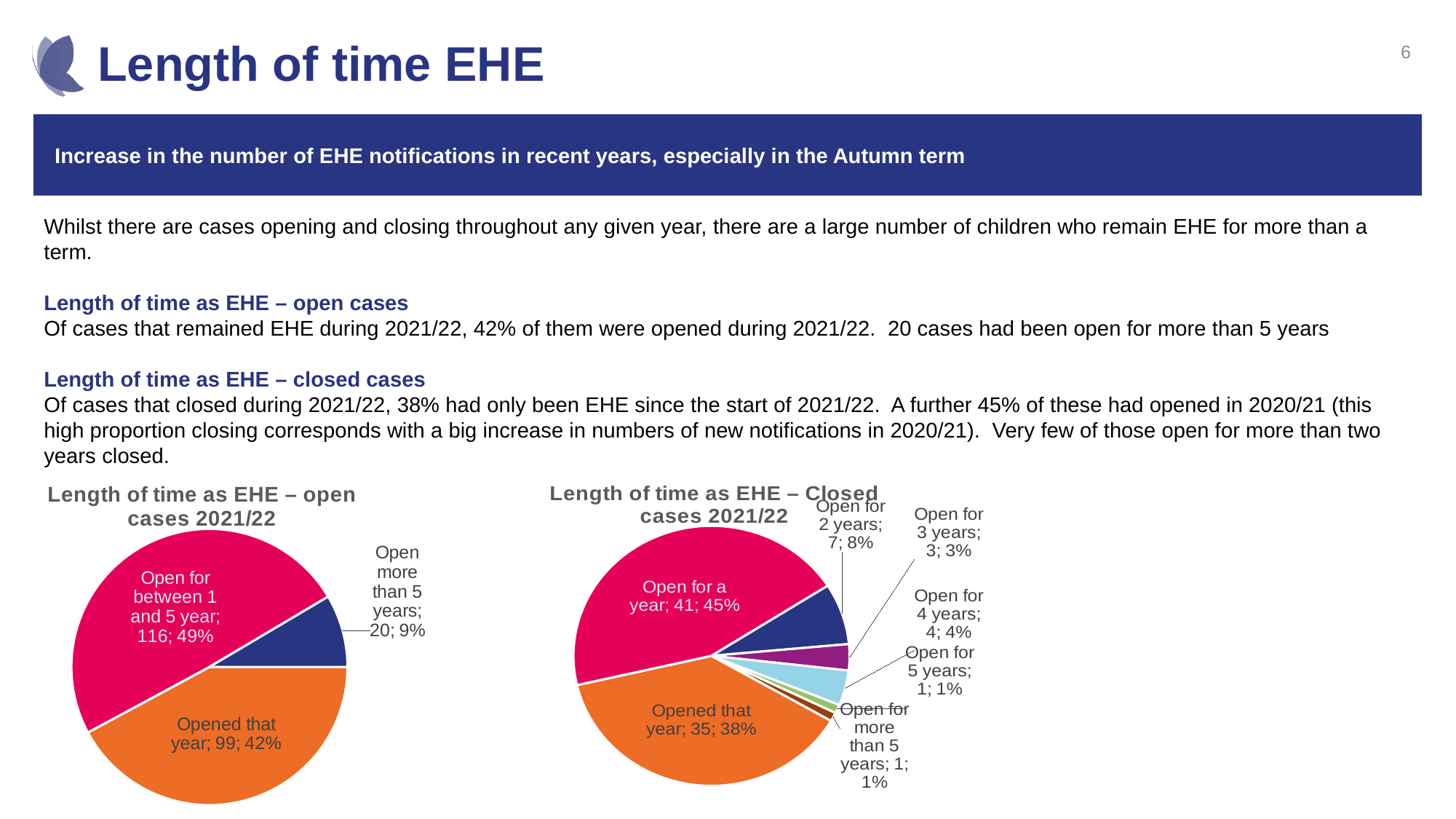
In the 'Length of time as EHE – open cases 2021/22' chart, what share of the pie is 'Open more than 5 years'? 9% In the 'Length of time as EHE – Closed cases 2021/22' chart, how many cases had been open for a year? 41 What type of chart is used for 'Length of time as EHE – Closed cases 2021/22'? Pie chart How many slices does the 'Length of time as EHE – open cases 2021/22' pie chart have? 3 In the 'Length of time as EHE – open cases 2021/22' chart, which category has the smallest slice? Open more than 5 years In the 'Length of time as EHE – Closed cases 2021/22' chart, what share of the pie is 'Opened that year'? 38% In the 'Length of time as EHE – open cases 2021/22' chart, how many cases were open for between 1 and 5 years? 116 In the 'Length of time as EHE – Closed cases 2021/22' chart, which category has the largest slice? Open for a year In the 'Length of time as EHE – Closed cases 2021/22' chart, which is larger: 'Open for 2 years' or 'Open for 4 years'? Open for 2 years In the 'Length of time as EHE – open cases 2021/22' chart, which category has the largest slice? Open for between 1 and 5 year In the 'Length of time as EHE – open cases 2021/22' chart, what is the difference between the number of cases open for between 1 and 5 years and the number opened that year? 17 How many slices does the 'Length of time as EHE – Closed cases 2021/22' pie chart have? 7